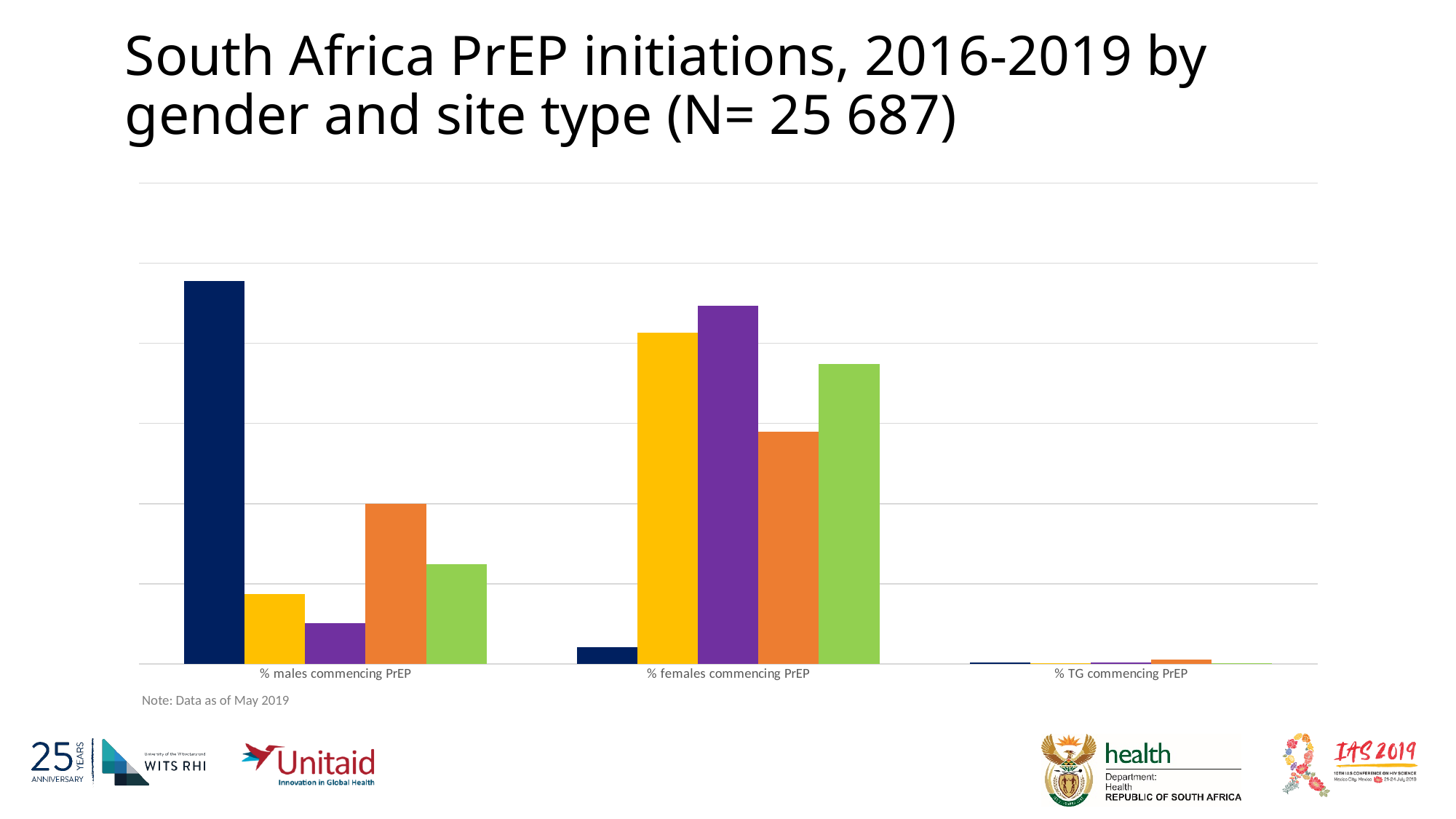
What is the title of the slide containing the chart? South Africa PrEP initiations, 2016-2019 by gender and site type (N= 25 687) What is the total N stated in the slide title? 25 687 How many categories are shown on the x axis of the chart? 3 How many bars are plotted for the category '% females commencing PrEP'? 5 Which category has the lowest bars overall in the chart? % TG commencing PrEP According to the note under the chart, as of when is the data? May 2019 What kind of chart is shown on the slide? bar chart What is the label of the first category on the x axis? % males commencing PrEP How many bars are plotted for the category '% males commencing PrEP'? 5 Which category contains the tallest single bar in the chart? % males commencing PrEP